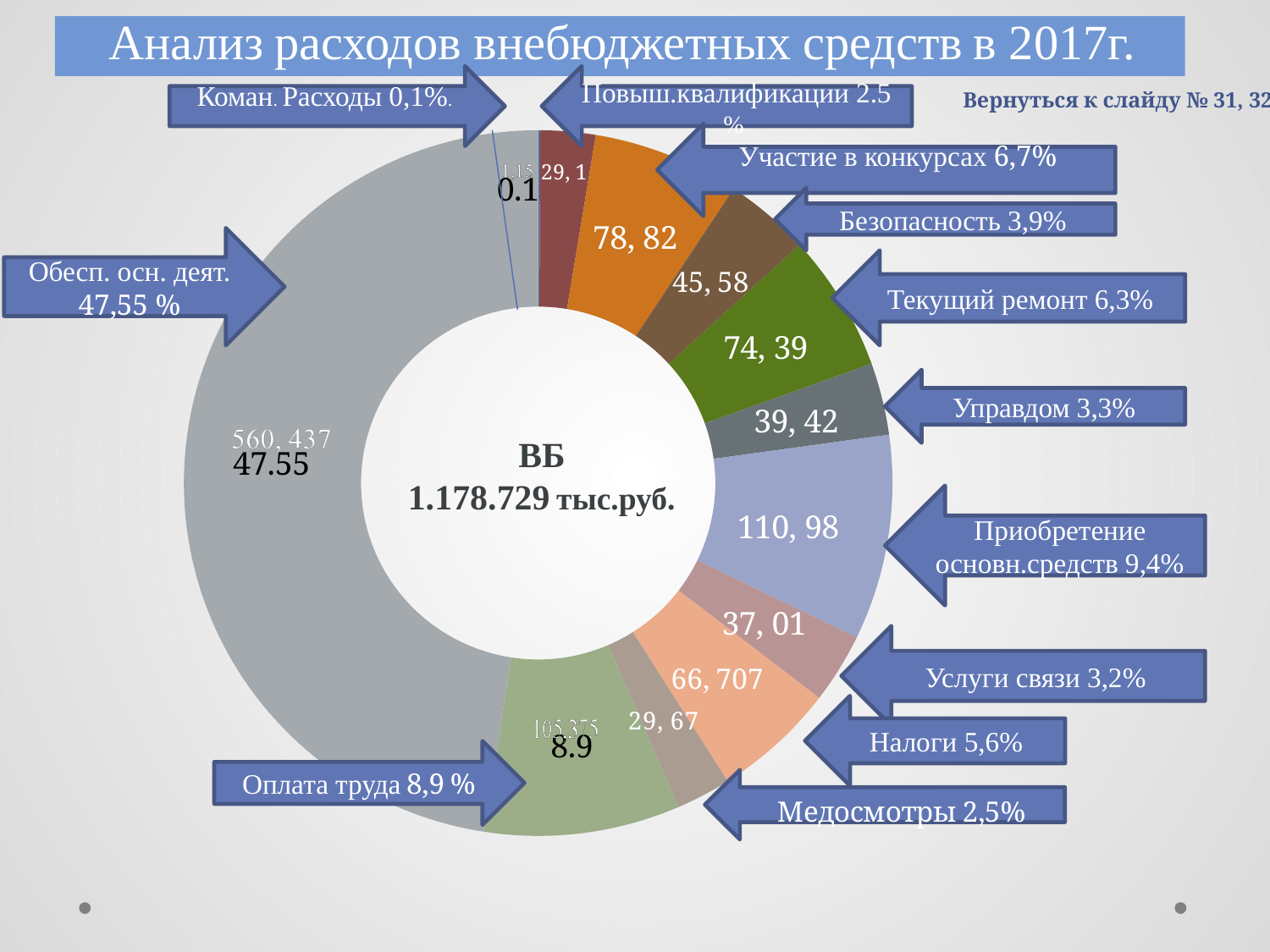
What value is printed on the 'Оплата труда' slice? 105,375 Which category has the smallest slice of the chart? Коман. Расходы What value is printed on the 'Приобретение основн.средств' slice? 110, 98 What kind of chart is shown on the slide? doughnut (pie) chart What share of expenses does 'Обесп. осн. деят.' account for? 47,55 % Which is larger: 'Участие в конкурсах' or 'Текущий ремонт'? Участие в конкурсах How many expense categories are shown in the chart? 12 Which is larger: 'Безопасность' or 'Услуги связи'? Безопасность What total amount is printed in the centre of the chart? ВБ 1.178.729 тыс.руб. What percentage is shown for 'Налоги'? 5,6% Which category has the largest slice of the chart? Обесп. осн. деят. What is the difference in percentage share between 'Приобретение основн.средств' and 'Оплата труда'? 0,5%